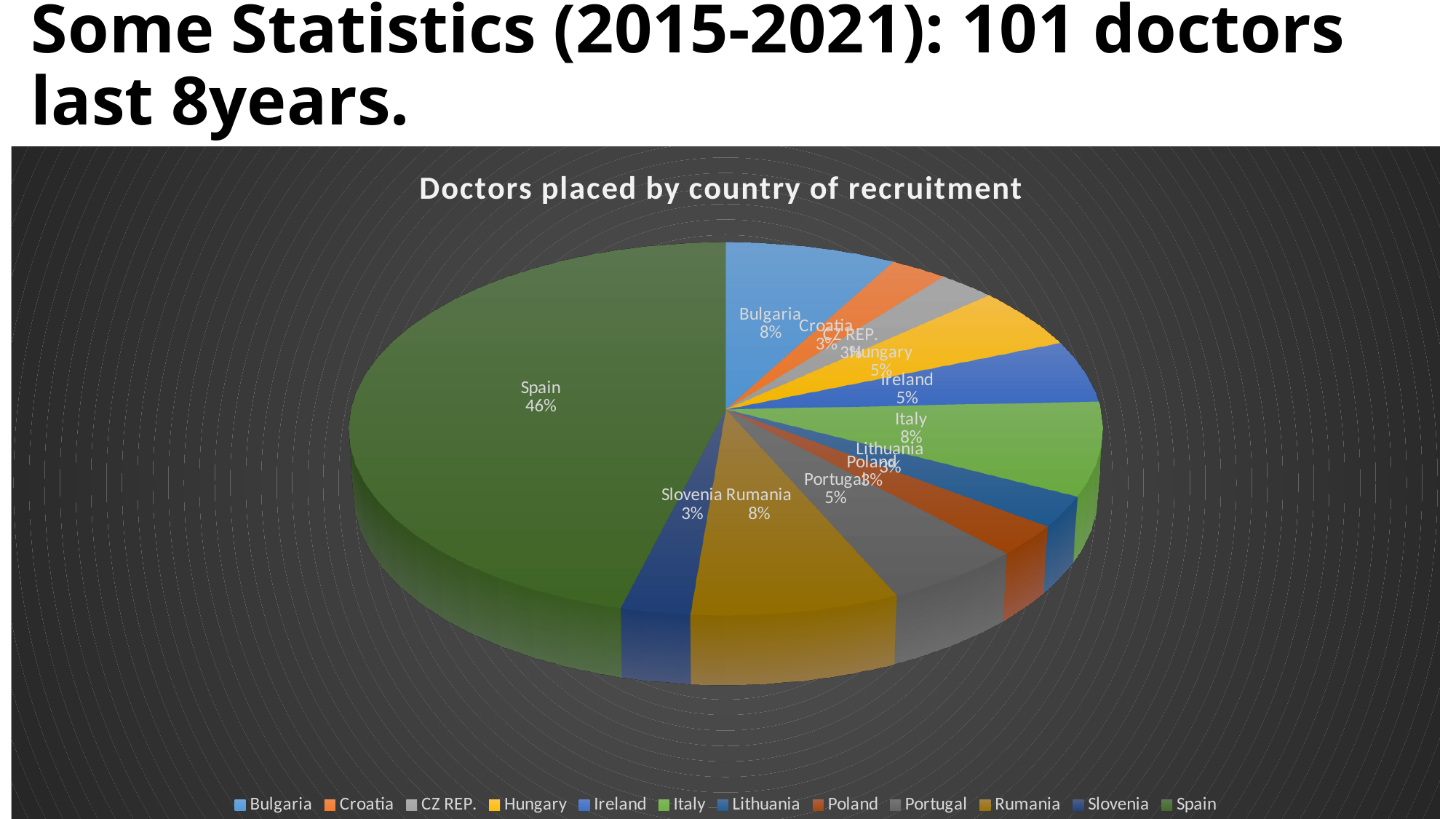
How many countries are listed in the legend? 12 What percentage is shown for Rumania? 8% Which is larger, the share for Ireland or the share for Croatia? Ireland What percentage is shown for Hungary? 5% What is the title of the chart? Doctors placed by country of recruitment Which country has the largest slice of the pie? Spain What percentage is shown for Slovenia? 3% What is the difference in percentage points between Spain and Italy? 38 What percentage is shown for Bulgaria? 8% What share of the pie does Spain account for? 46% What percentage is shown for Portugal? 5% What type of chart is shown on the slide? pie chart